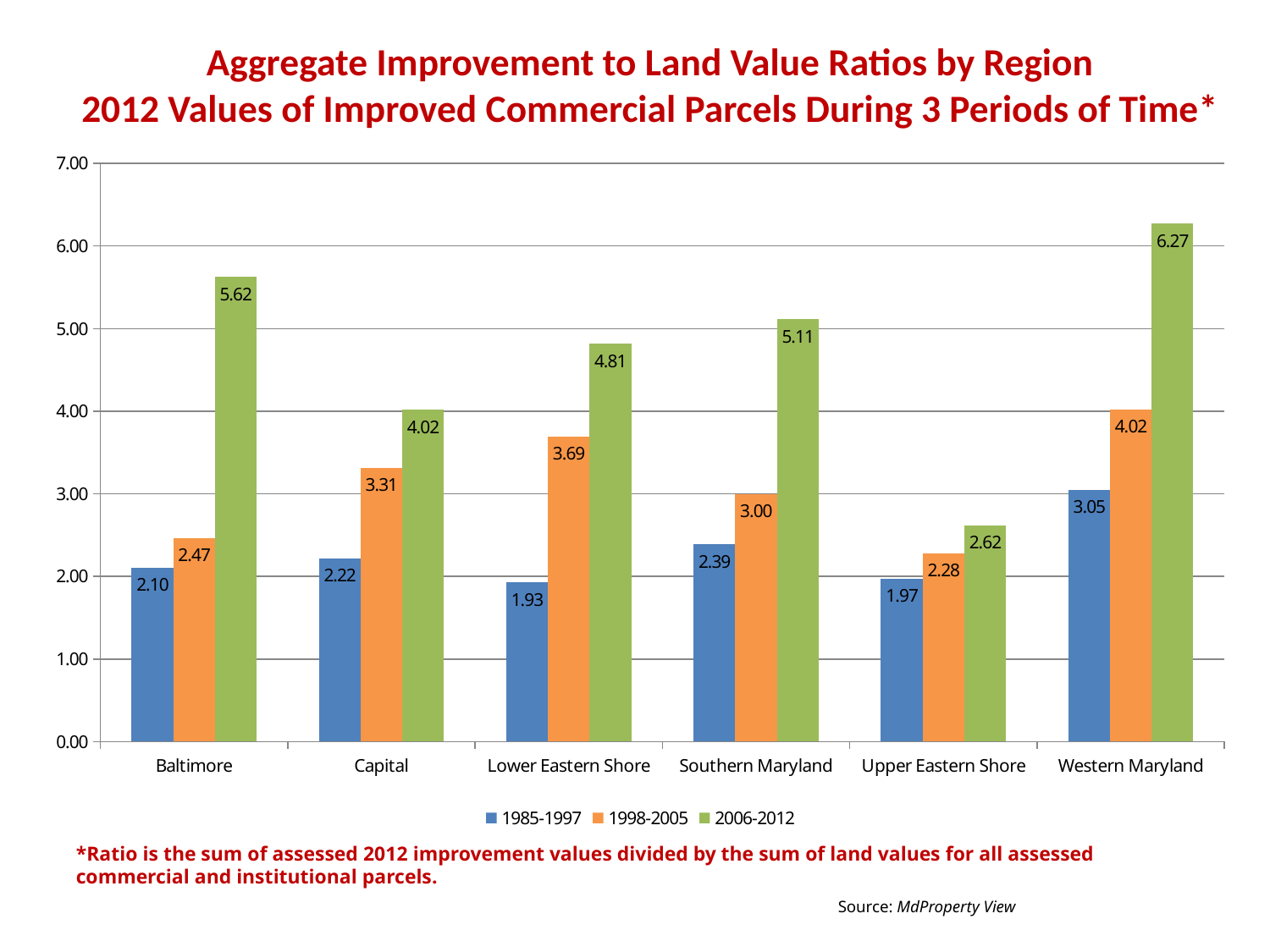
What is the difference between the 2006-2012 and 1985-1997 values for Baltimore? 3.52 What is the 1998-2005 value for Capital? 3.31 What is the 1985-1997 value for Lower Eastern Shore? 1.93 How many series does the legend list? 3 What is the source cited at the bottom of the slide? MdProperty View Which series is shown in green in the legend? 2006-2012 Which region has the highest 2006-2012 value? Western Maryland Which is larger, the 1998-2005 value for Southern Maryland or the 1998-2005 value for Upper Eastern Shore? Southern Maryland Which region has the lowest 1985-1997 value? Lower Eastern Shore What is the 2006-2012 value for Western Maryland? 6.27 What kind of chart is shown on the slide? Bar chart How many regions are shown on the x axis? 6